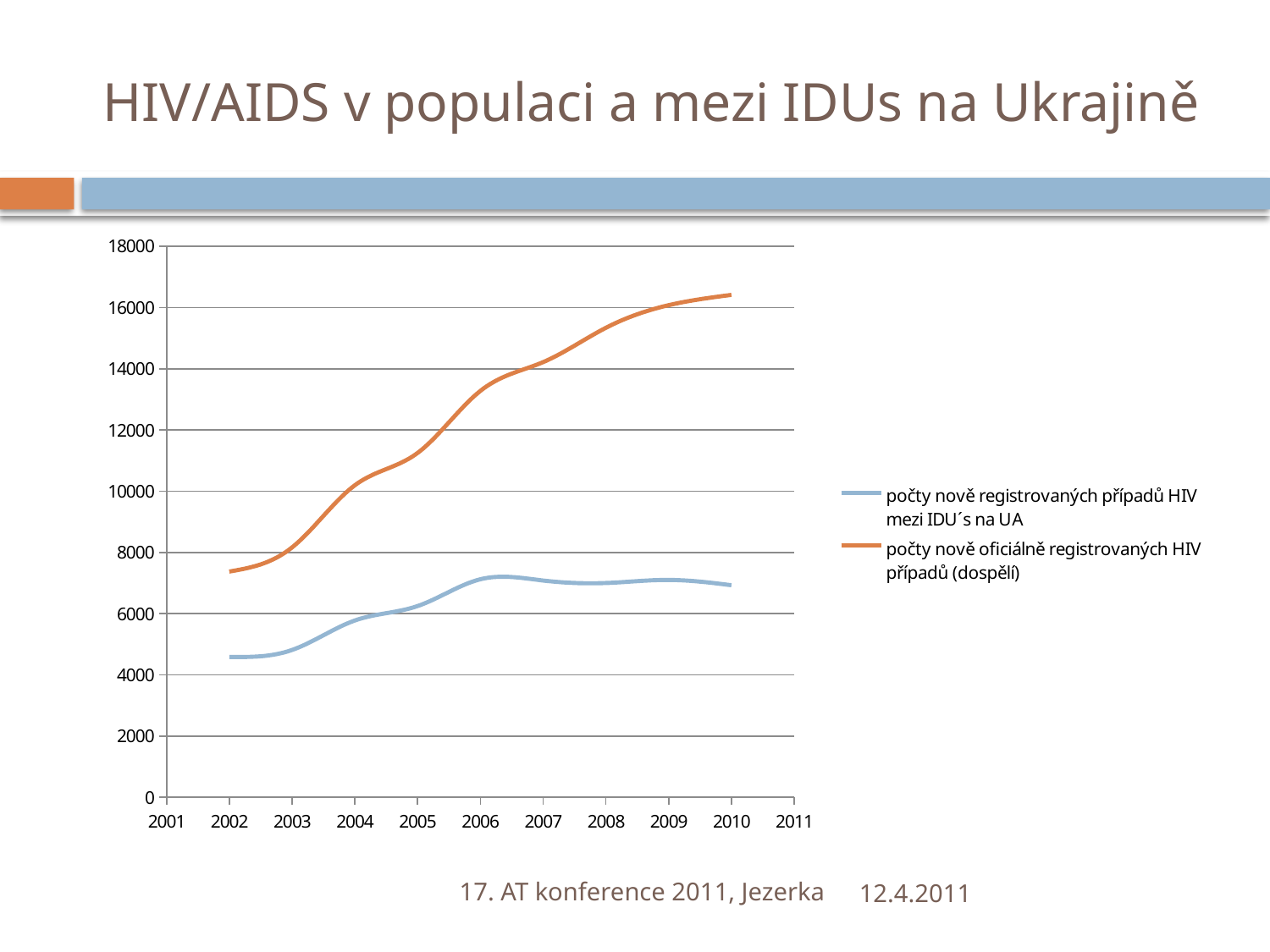
Do the values of the series 'počty nově oficiálně registrovaných HIV případů (dospělí)' rise or fall from 2002 to 2010? rise Is the value for 2002 in the series 'počty nově registrovaných případů HIV mezi IDU´s na UA' greater or less than 4000? greater Is the value for 2006 in the series 'počty nově registrovaných případů HIV mezi IDU´s na UA' greater or less than 8000? less How many series does the legend list? 2 In which year is the series 'počty nově oficiálně registrovaných HIV případů (dospělí)' at its highest? 2010 Is the value for 2002 in the series 'počty nově oficiálně registrovaných HIV případů (dospělí)' greater or less than 8000? less What kind of chart is shown on the slide? line chart What colour is the line for 'počty nově registrovaných případů HIV mezi IDU´s na UA'? blue Which series has the larger value in 2010? počty nově oficiálně registrovaných HIV případů (dospělí) How many years are plotted for each series? 9